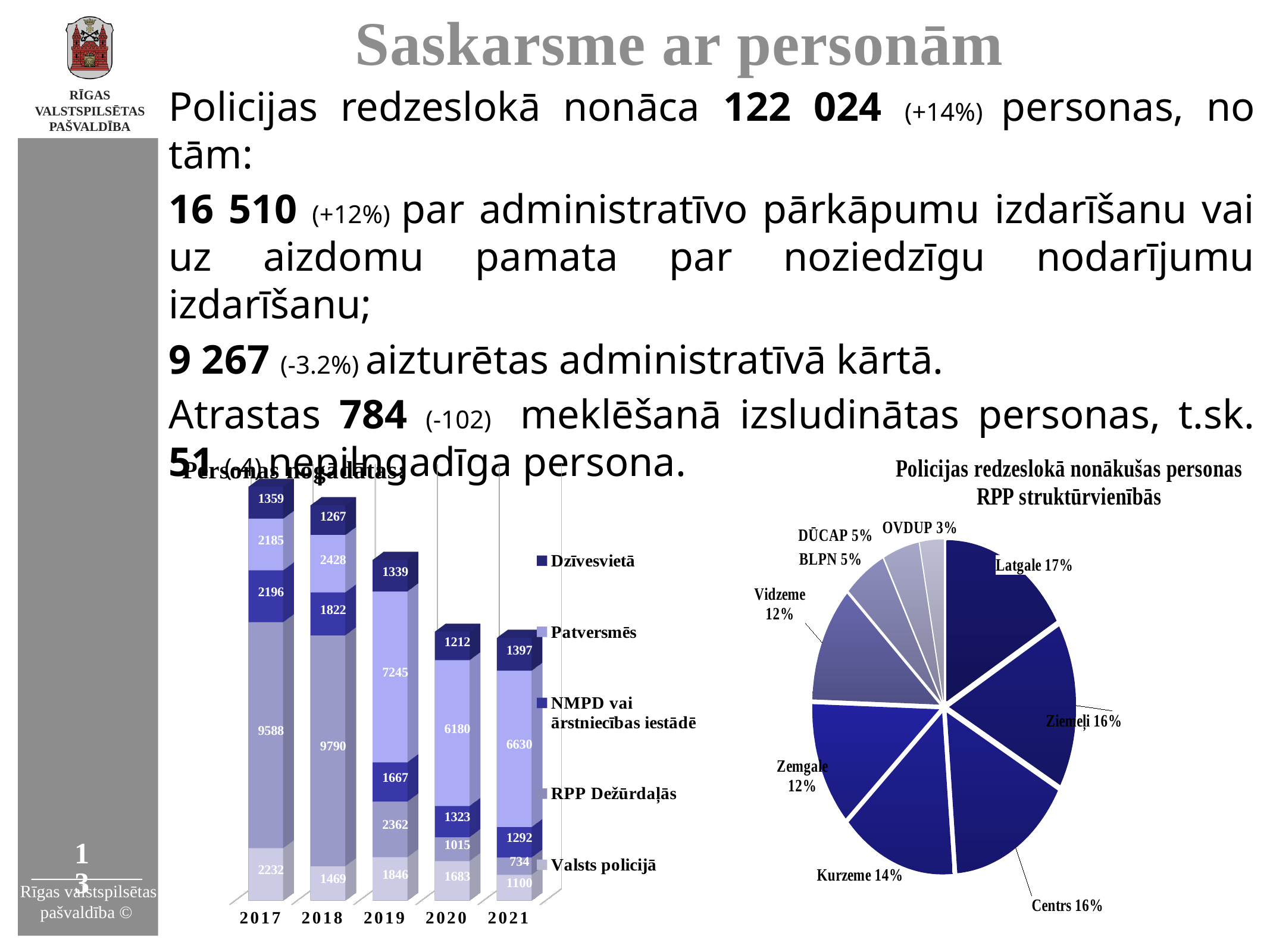
How many series does the legend of the stacked bar chart on the left list? 5 In the stacked bar chart on the left, what is the total of the 2021 bar? 11153 How many years are shown on the x axis of the stacked bar chart on the left? 5 In the stacked bar chart on the left, what is the value for RPP Dežūrdaļās in 2017? 9588 In the pie chart 'Policijas redzeslokā nonākušas personas RPP struktūrvienībās', which unit has the smallest share? OVDUP In the pie chart 'Policijas redzeslokā nonākušas personas RPP struktūrvienībās', which unit has the largest share? Latgale In the stacked bar chart on the left, what is the difference between the Patversmēs values for 2019 and 2018? 4817 In the pie chart 'Policijas redzeslokā nonākušas personas RPP struktūrvienībās', what share does Latgale have? 17% What kind of chart is the chart on the left of the slide? Stacked bar chart How many slices does the pie chart 'Policijas redzeslokā nonākušas personas RPP struktūrvienībās' have? 9 In the stacked bar chart on the left, is the Valsts policijā value larger in 2017 or in 2021? 2017 In the stacked bar chart on the left, what is the value for Dzīvesvietā in 2021? 1397